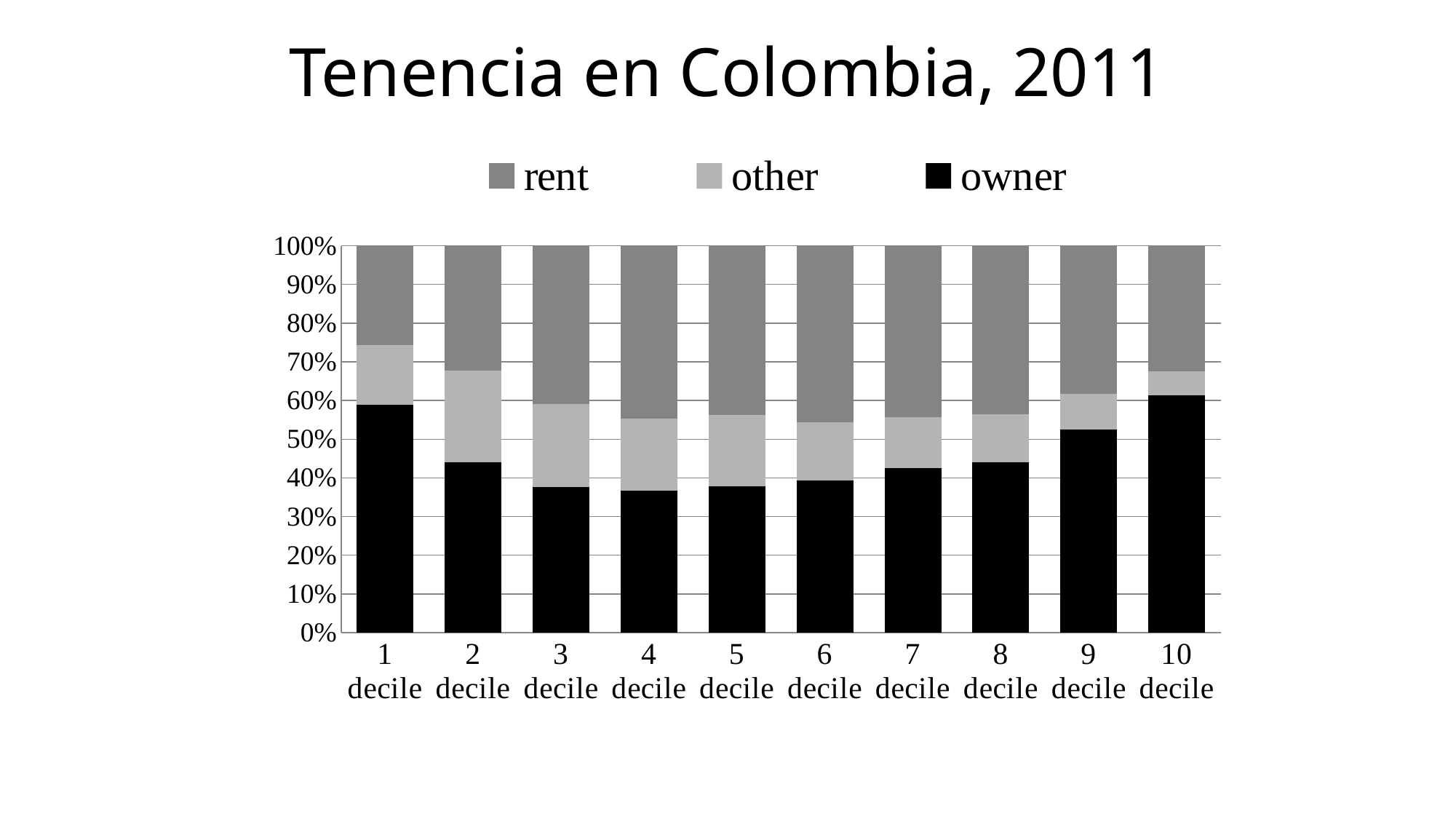
What is the title of the chart? Tenencia en Colombia, 2011 Which has the larger owner share, the 1 decile or the 2 decile? 1 decile What kind of chart is shown on the slide? Stacked bar chart How many deciles are shown on the x axis? 10 Which decile has the largest owner share? 10 decile How many series does the legend list? 3 Which decile has the smallest 'other' share? 10 decile Which series is drawn in black? owner Which decile has the smallest rent share? 1 decile Is the owner share for the 1 decile greater or less than 50%? greater Is the owner share for the 4 decile greater or less than 40%? less Which decile has the largest 'other' share? 2 decile